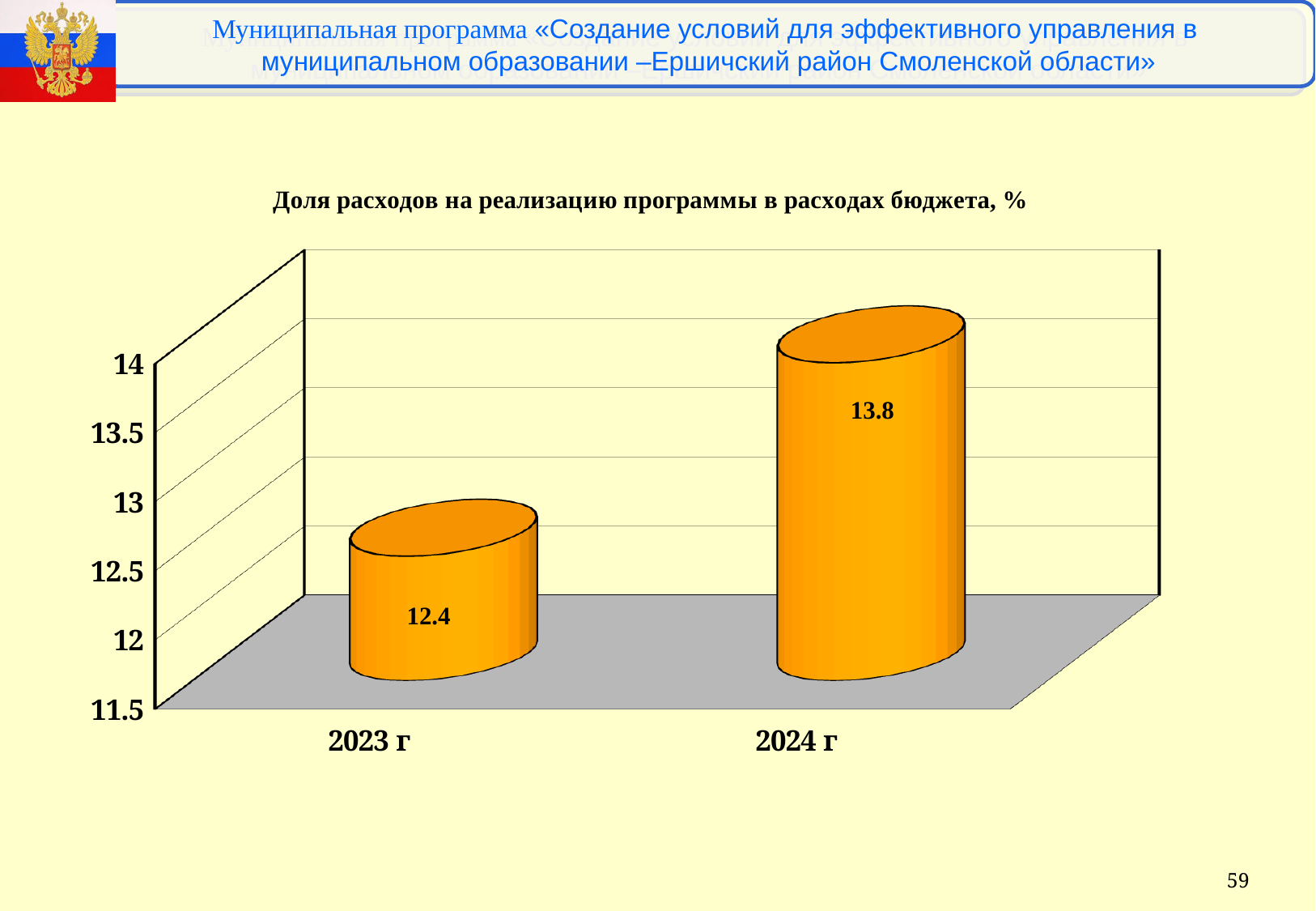
What is the title of the chart? Доля расходов на реализацию программы в расходах бюджета, % Do the values rise or fall from 2023 г to 2024 г? rise Is the value for 2023 г greater or less than 13? less Is the value for 2024 г greater or less than 13.5? greater Which year has the lowest value? 2023 г What is the difference between the values for 2024 г and 2023 г? 1.4 How many categories are shown on the x axis? 2 Which is larger, the value for 2023 г or the value for 2024 г? 2024 г What is the value for 2024 г? 13.8 What is the value for 2023 г? 12.4 Which year has the highest value? 2024 г What kind of chart is shown on the slide? bar chart